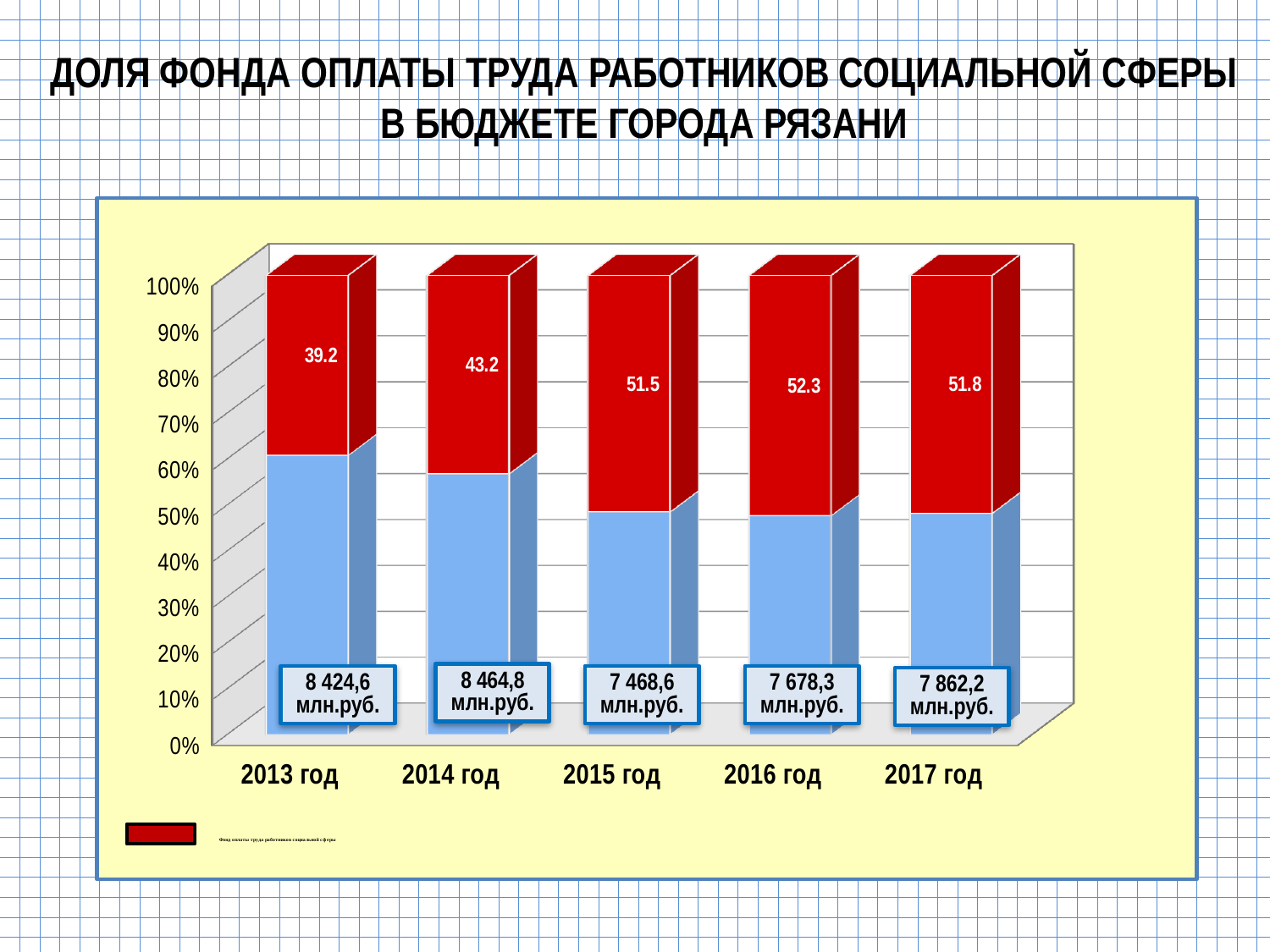
Which year has the largest amount in млн.руб. printed on its bar? 2014 год What is the difference between the red segment values for 2016 год and 2013 год? 13.1 What amount in млн.руб. is printed on the bar for 2015 год? 7 468,6 млн.руб. What amount in млн.руб. is printed on the bar for 2017 год? 7 862,2 млн.руб. Which year has the highest value printed on its red segment? 2016 год What kind of chart is shown on the slide? stacked bar chart Is the blue segment for 2013 год greater or less than 50%? greater Which year has the lowest value printed on its red segment? 2013 год Which is larger, the red segment value for 2014 год or for 2015 год? 2015 год What is the value printed on the red segment for 2016 год? 52.3 How many years are shown on the x axis? 5 What is the value printed on the red segment for 2013 год? 39.2